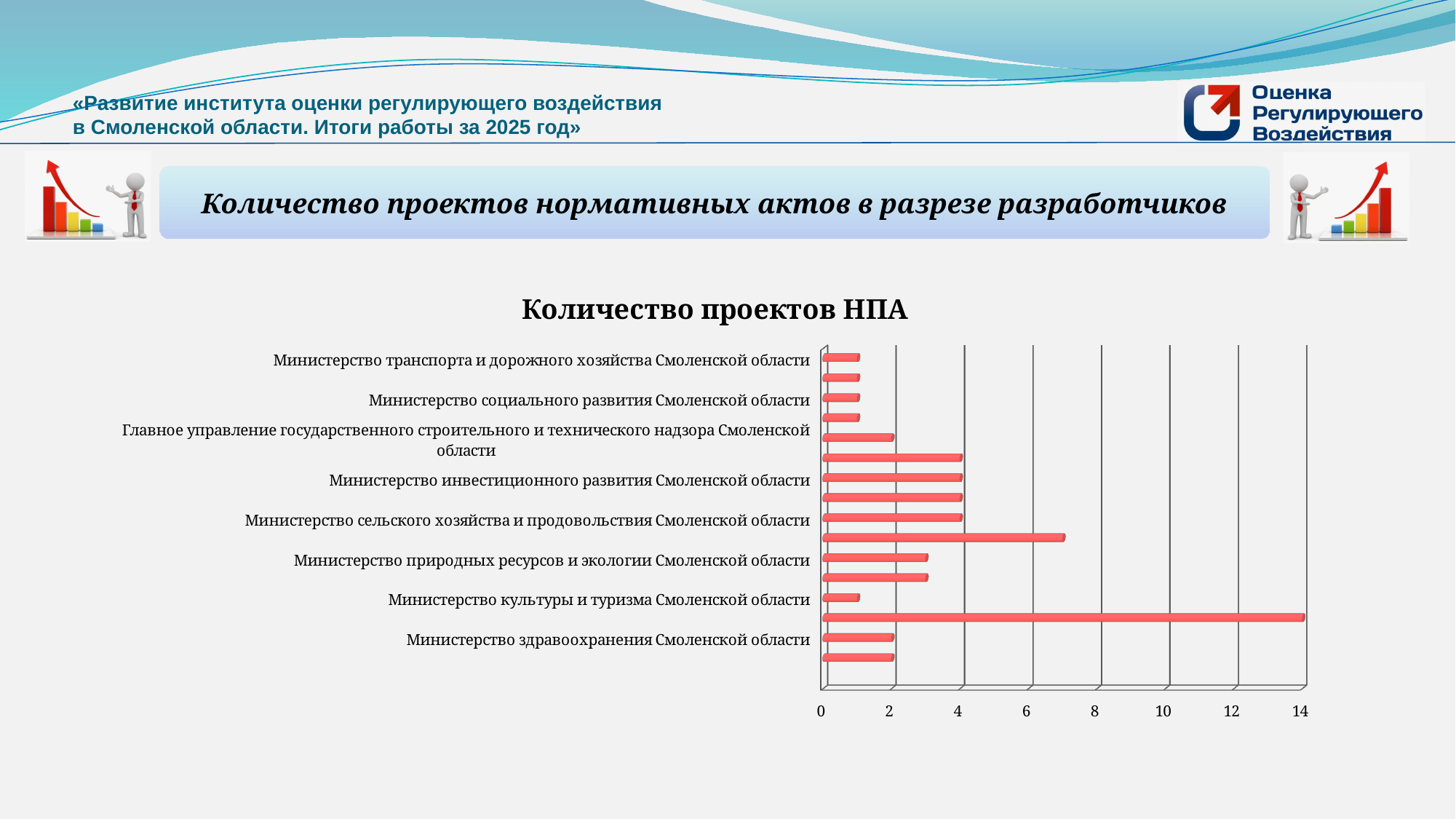
What is the value for Министерство здравоохранения Смоленской области? 2 What kind of chart is shown on the slide? bar chart Is the value for Министерство природных ресурсов и экологии Смоленской области greater or less than 2? greater What is the value for Главное управление государственного строительного и технического надзора Смоленской области? 2 Is the value for Министерство транспорта и дорожного хозяйства Смоленской области greater or less than 2? less What is the difference between the values for Министерство инвестиционного развития Смоленской области and Министерство здравоохранения Смоленской области? 2 Which has a larger value: Министерство инвестиционного развития Смоленской области or Министерство здравоохранения Смоленской области? Министерство инвестиционного развития Смоленской области What is the largest value shown by any bar in the chart? 14 What is the value for Министерство сельского хозяйства и продовольствия Смоленской области? 4 What is the title of the chart? Количество проектов НПА How many bars are plotted in the chart? 16 What is the value for Министерство инвестиционного развития Смоленской области? 4